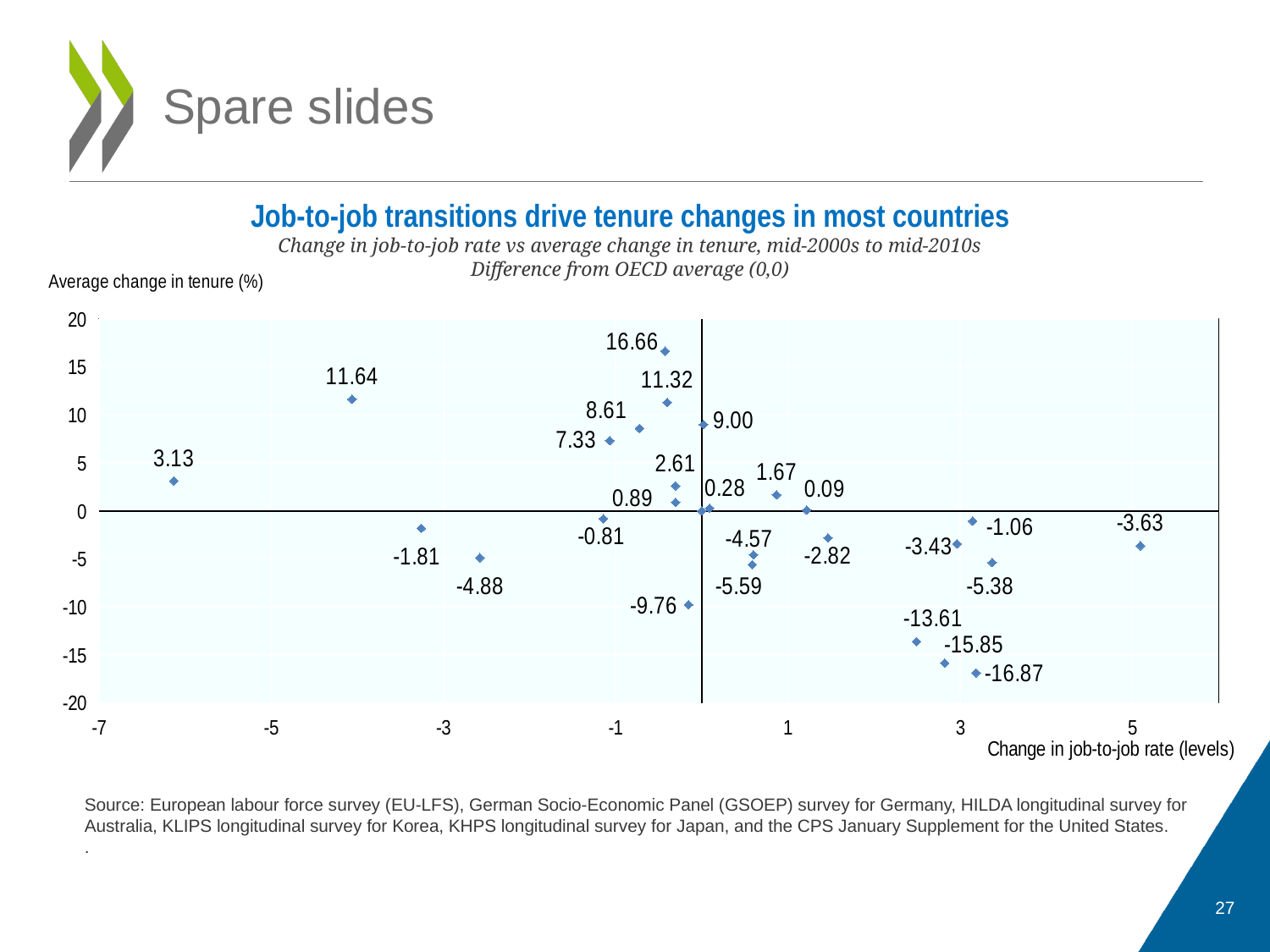
Is the point labelled 16.66 above or below the 15 gridline on the vertical axis? above Which labelled value is larger on the chart, 11.64 or 11.32? 11.64 What is the lowest data label value shown on the chart? -16.87 Which labelled value is larger on the chart, -4.88 or -1.81? -1.81 What is the label of the vertical axis of the chart? Average change in tenure (%) Is the point labelled -16.87 greater or less than -15 on the vertical axis? less What is the maximum value shown on the vertical axis of the chart? 20 What is the difference between the highest labelled value (16.66) and the lowest labelled value (-16.87) on the chart? 33.53 What is the highest data label value shown on the chart? 16.66 What is the difference between the labelled values 9.00 and 8.61 on the chart? 0.39 What kind of chart is shown on the slide? Scatter chart What is the title of the chart? Job-to-job transitions drive tenure changes in most countries